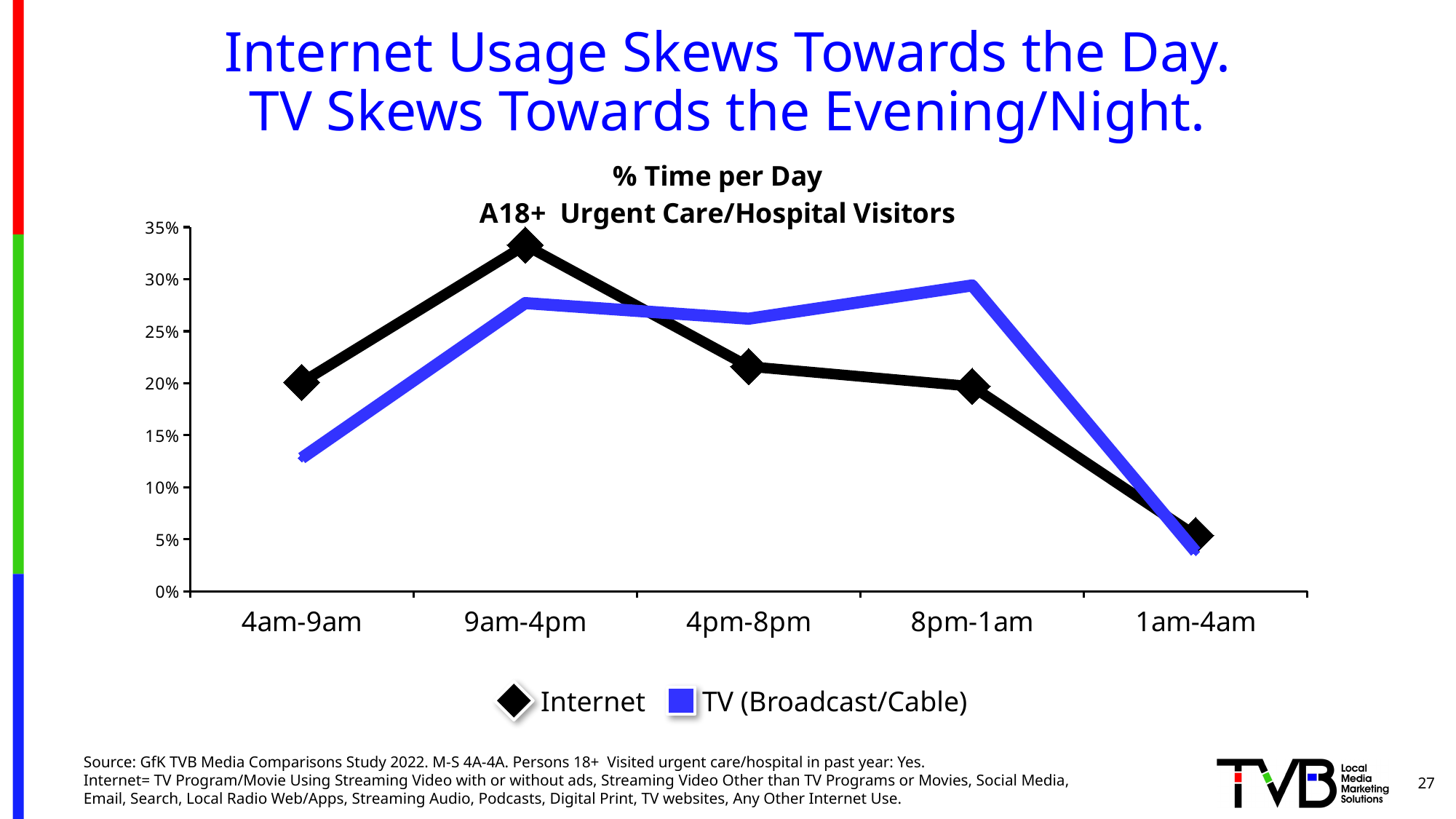
Is the Internet value for 9am-4pm greater or less than 30%? greater For the 4am-9am period, which is larger: Internet or TV (Broadcast/Cable)? Internet Does the Internet line rise or fall from 9am-4pm to 1am-4am? fall How many time periods are shown on the x axis? 5 What kind of chart is shown on the slide? line chart For the 8pm-1am period, which is larger: Internet or TV (Broadcast/Cable)? TV (Broadcast/Cable) How many series does the legend list? 2 Is the TV (Broadcast/Cable) value for 4am-9am greater or less than 10%? greater In which time period is the Internet value highest? 9am-4pm In which time period is the Internet value lowest? 1am-4am In which time period is the TV (Broadcast/Cable) value lowest? 1am-4am Which series are listed in the legend? Internet and TV (Broadcast/Cable)